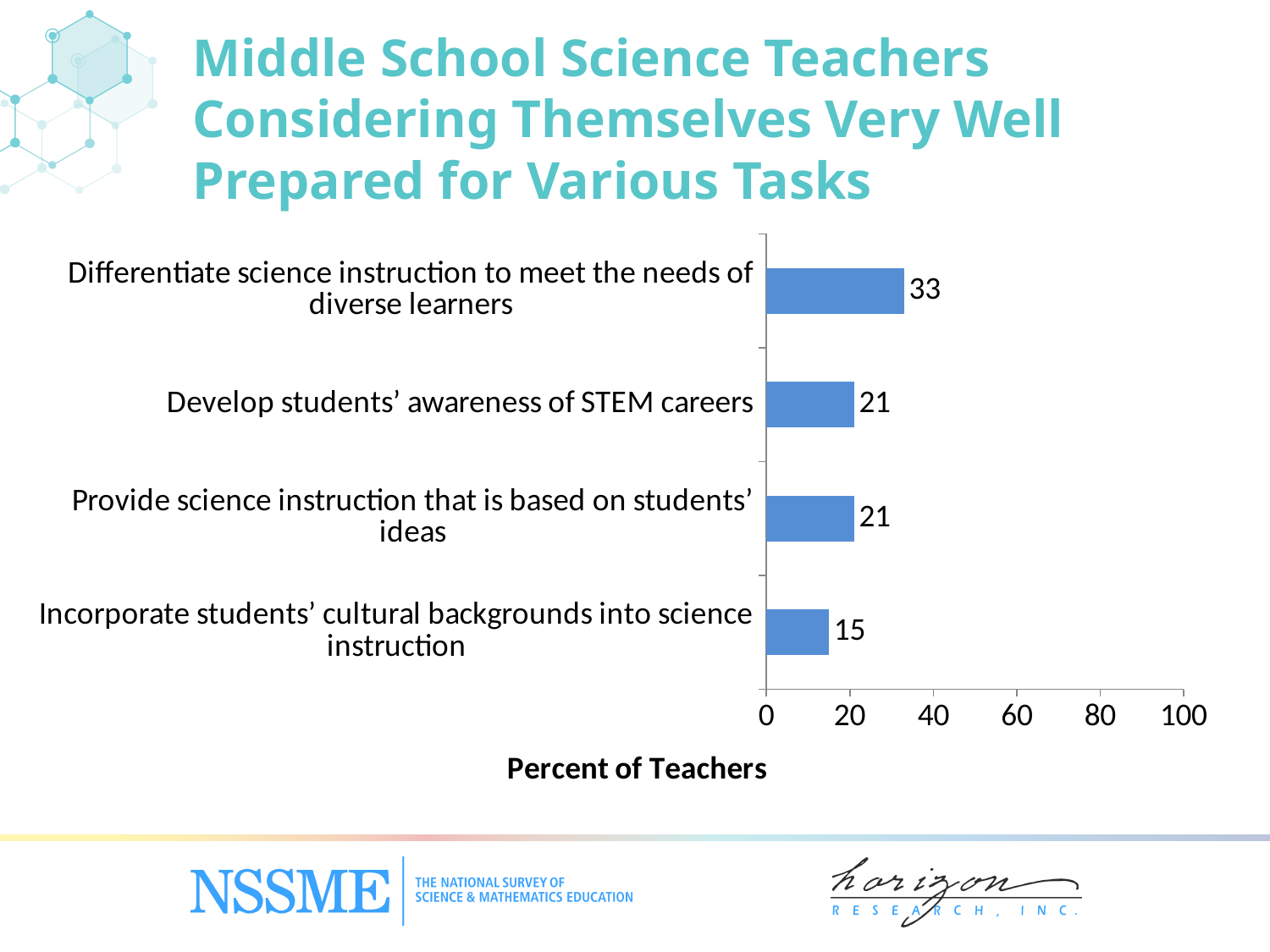
What percent of teachers consider themselves very well prepared to differentiate science instruction to meet the needs of diverse learners? 33 Which is larger: the value for 'Provide science instruction that is based on students' ideas' or the value for 'Incorporate students' cultural backgrounds into science instruction'? Provide science instruction that is based on students' ideas What is the value for 'Develop students' awareness of STEM careers'? 21 What is the difference between the value for differentiating science instruction and the value for developing students' awareness of STEM careers? 12 What is the label of the horizontal axis? Percent of Teachers What is the value for 'Incorporate students' cultural backgrounds into science instruction'? 15 How many tasks are shown in the chart? 4 What is the difference between the value for differentiating science instruction and the value for incorporating students' cultural backgrounds? 18 Is the value for 'Differentiate science instruction to meet the needs of diverse learners' greater or less than 40? less Which task has the lowest percent of teachers considering themselves very well prepared? Incorporate students' cultural backgrounds into science instruction Which task has the highest percent of teachers considering themselves very well prepared? Differentiate science instruction to meet the needs of diverse learners What kind of chart is shown on the slide? Bar chart